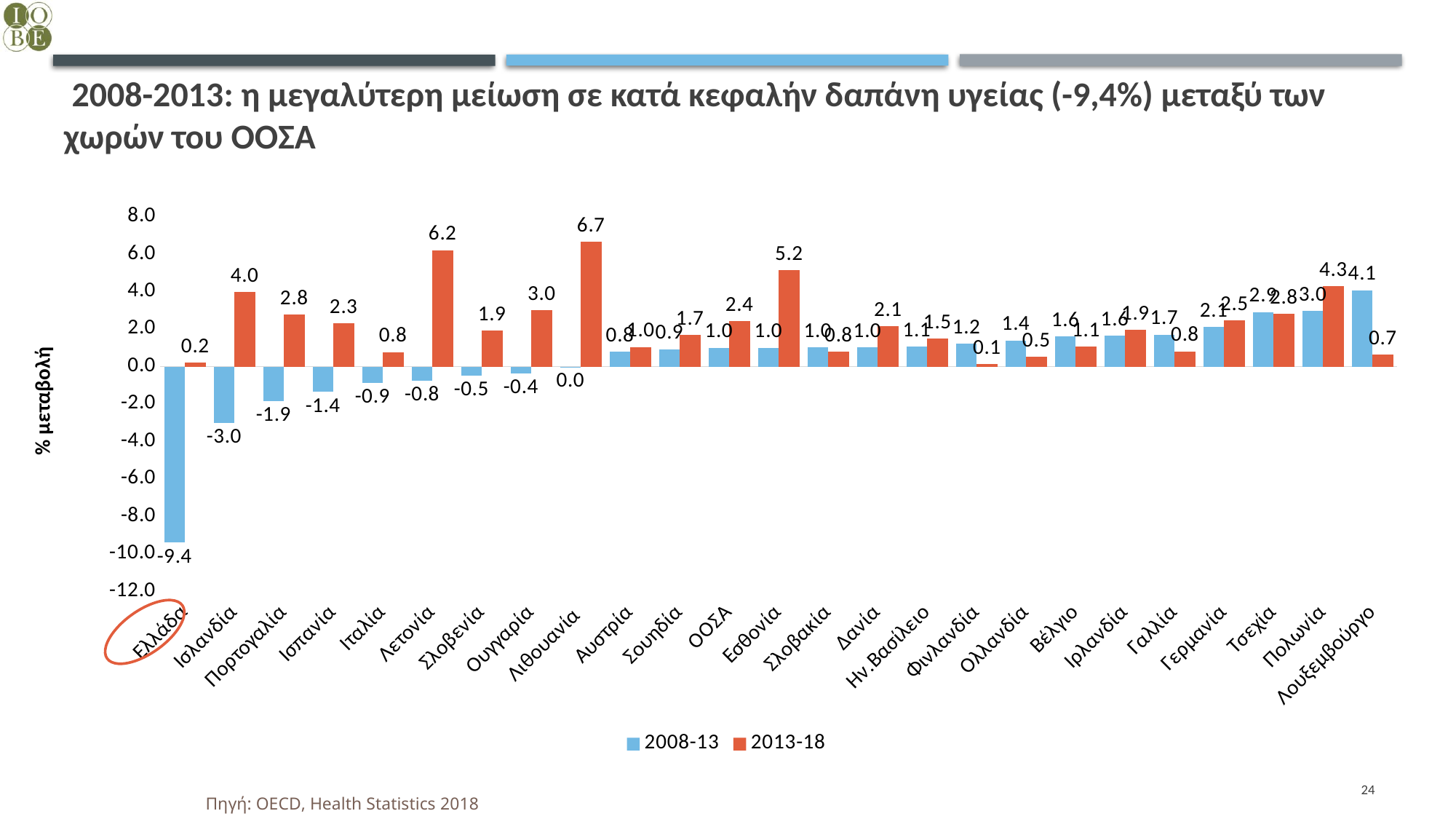
What is the label of the vertical axis? % μεταβολή How many categories are shown on the x axis? 25 Which country has the highest value in the 2013-18 series? Λιθουανία What is the value for Λετονία in the 2013-18 series? 6.2 Which category has the lowest value in the 2008-13 series? Ελλάδα Which category has the highest value in the 2008-13 series? Λουξεμβούργο What is the difference between the 2013-18 and 2008-13 values for Ισλανδία? 7.0 What kind of chart is shown on the slide? Bar chart What is the value for Ελλάδα in the 2008-13 series? -9.4 How many series does the legend list? 2 Which is larger for 2013-18: Λετονία or Εσθονία? Λετονία What is the value for Λουξεμβούργο in the 2008-13 series? 4.1